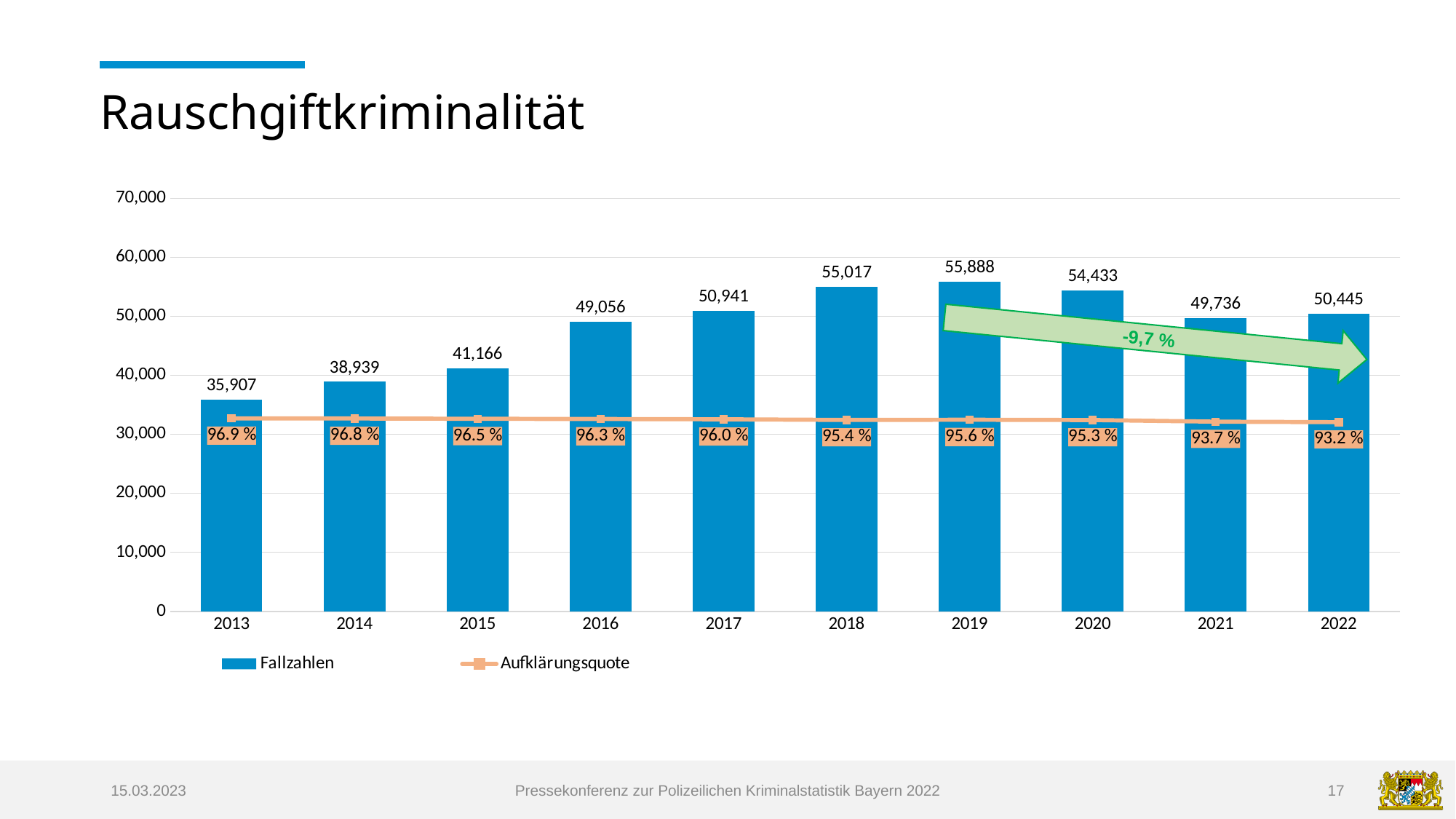
How many years are shown on the x axis? 10 How many series does the legend list? 2 Does the Aufklärungsquote rise or fall from 2013 to 2022? Fall Which year has the lowest Fallzahlen? 2013 What is the Aufklärungsquote for 2022? 93.2 % What percentage change is written on the green arrow? -9,7 % Which year has the highest Fallzahlen? 2019 What is the Fallzahlen value for 2013? 35,907 What is the Fallzahlen value for 2019? 55,888 What kind of chart is shown on the slide? Bar chart with a line series Which year has the higher Fallzahlen, 2021 or 2022? 2022 What is the difference in Fallzahlen between 2019 and 2022? 5,443